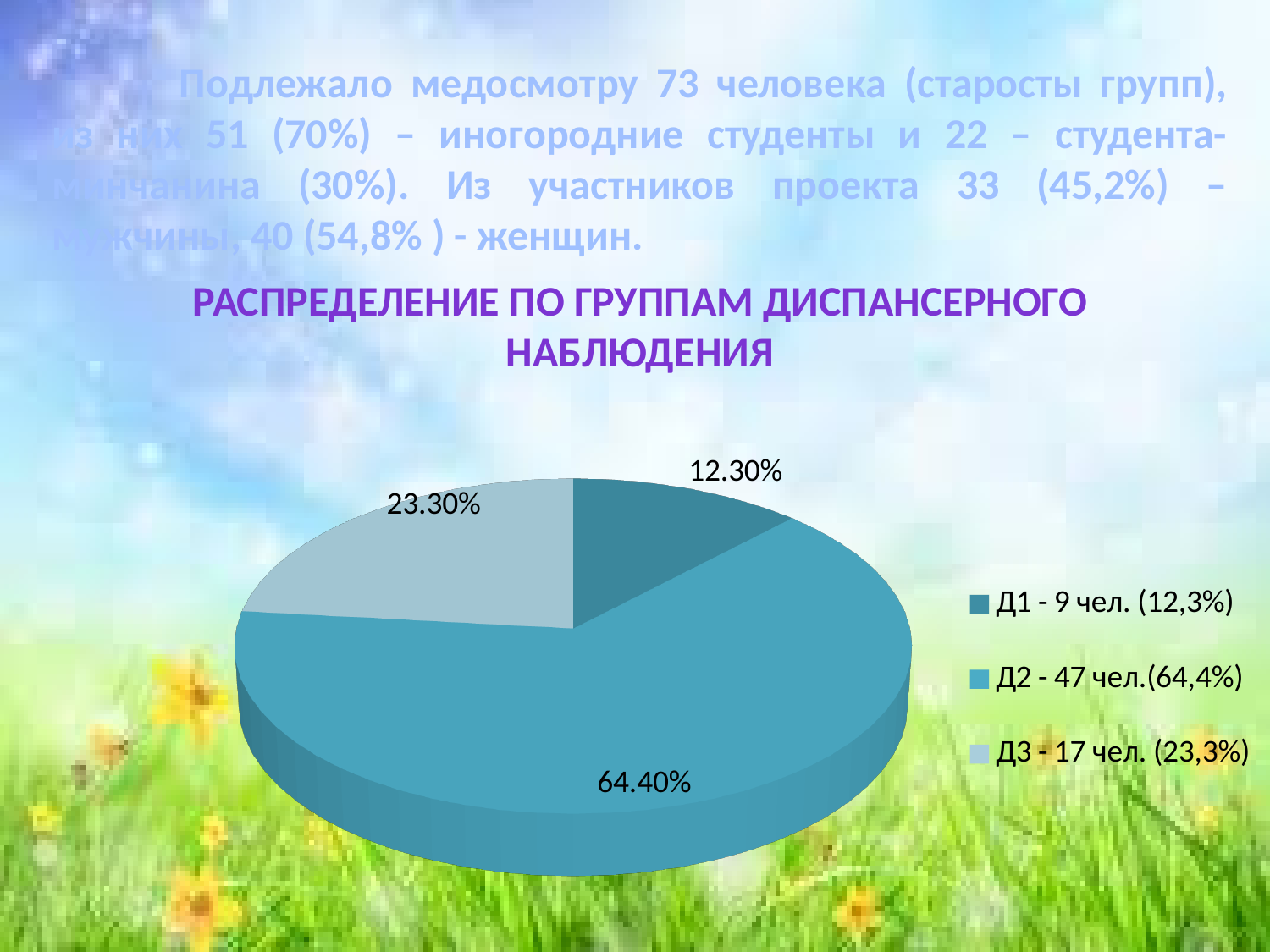
How many entries does the legend of the pie chart list? 3 According to the legend, how many people are in group Д3? 17 чел. What percentage is shown on the pie chart for the Д2 slice? 64.40% What is the difference in percentage points between the Д2 slice and the Д3 slice? 41.10% What percentage is shown on the pie chart for the Д3 slice? 23.30% What percentage is shown on the pie chart for the Д1 slice? 12.30% How many slices does the pie chart have? 3 Which group has the smallest slice of the pie chart? Д1 Which slice is larger, Д3 or Д1? Д3 What is the title of the pie chart? РАСПРЕДЕЛЕНИЕ ПО ГРУППАМ ДИСПАНСЕРНОГО НАБЛЮДЕНИЯ Which group has the largest slice of the pie chart? Д2 What kind of chart is shown on the slide? pie chart